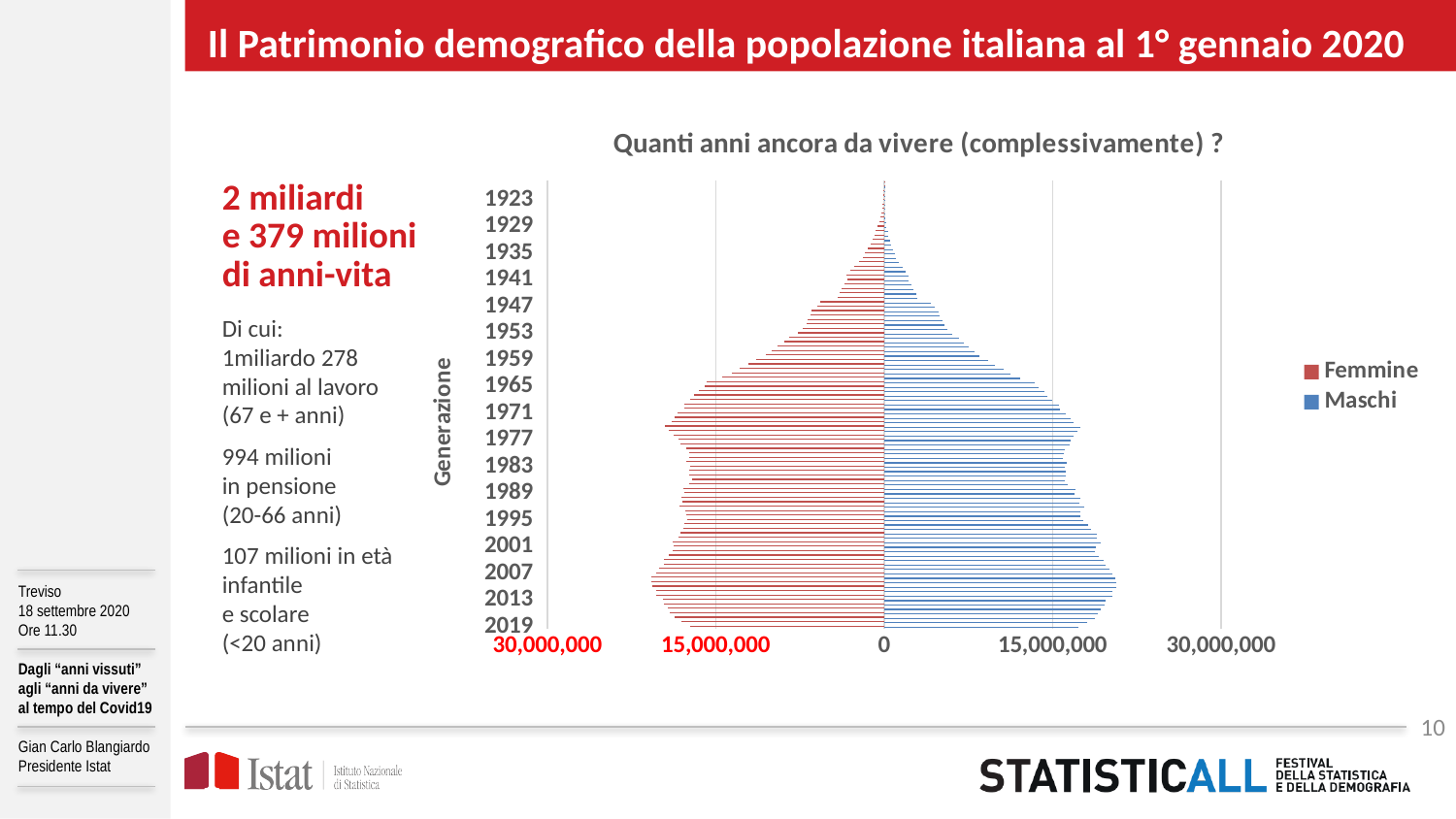
Which colour represents the Femmine series in the chart? red Is the Femmine value for generation 1923 greater or less than 15,000,000? less How many series does the chart legend list? 2 Is the Femmine value for generation 1977 greater or less than 15,000,000? greater Which is larger: the Femmine value for generation 1923 or the Femmine value for generation 2019? 2019 Do the Maschi values generally rise or fall when moving from generation 1923 down to generation 2019? rise Is the Femmine value for generation 1947 greater or less than 15,000,000? less How many year labels are shown on the vertical axis of the chart? 17 What is the title of the chart? Quanti anni ancora da vivere (complessivamente) ? What kind of chart is shown on the slide? bar chart Which is larger: the Maschi value for generation 2013 or the Maschi value for generation 1935? 2013